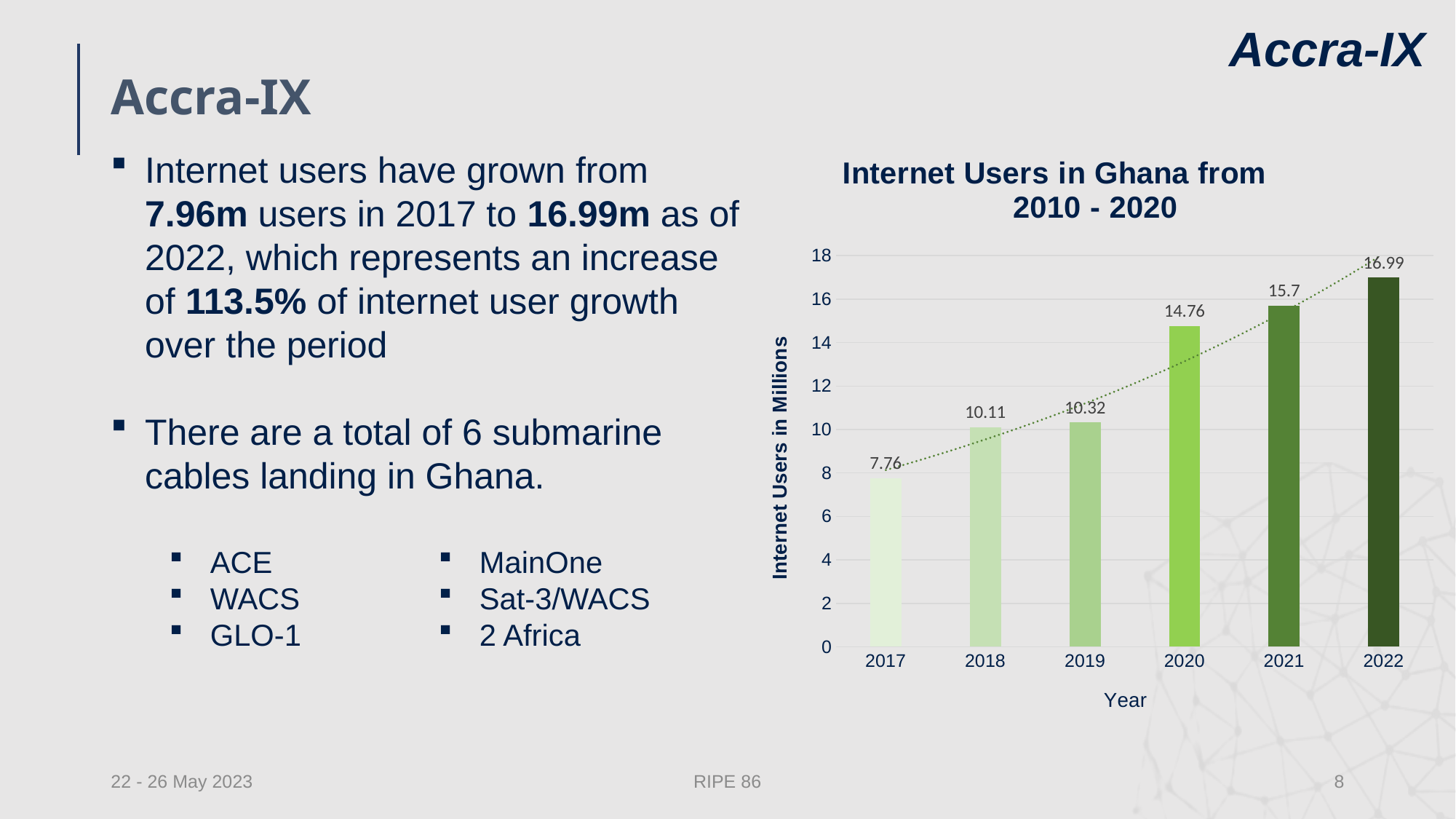
Do the values rise or fall from 2017 to 2022? Rise How many years are shown on the x axis of the chart? 6 What is the value for 2020 in the chart? 14.76 Which year has the lowest value in the chart? 2017 What kind of chart is shown on the slide? Bar chart What is the difference between the values for 2022 and 2017? 9.23 Which year has the highest value in the chart? 2022 What is the value for 2017 in the chart? 7.76 What is the value for 2022 in the chart? 16.99 What is the value for 2019 in the chart? 10.32 What is the difference between the values for 2020 and 2019? 4.44 Which is larger, the value for 2018 or the value for 2021? 2021